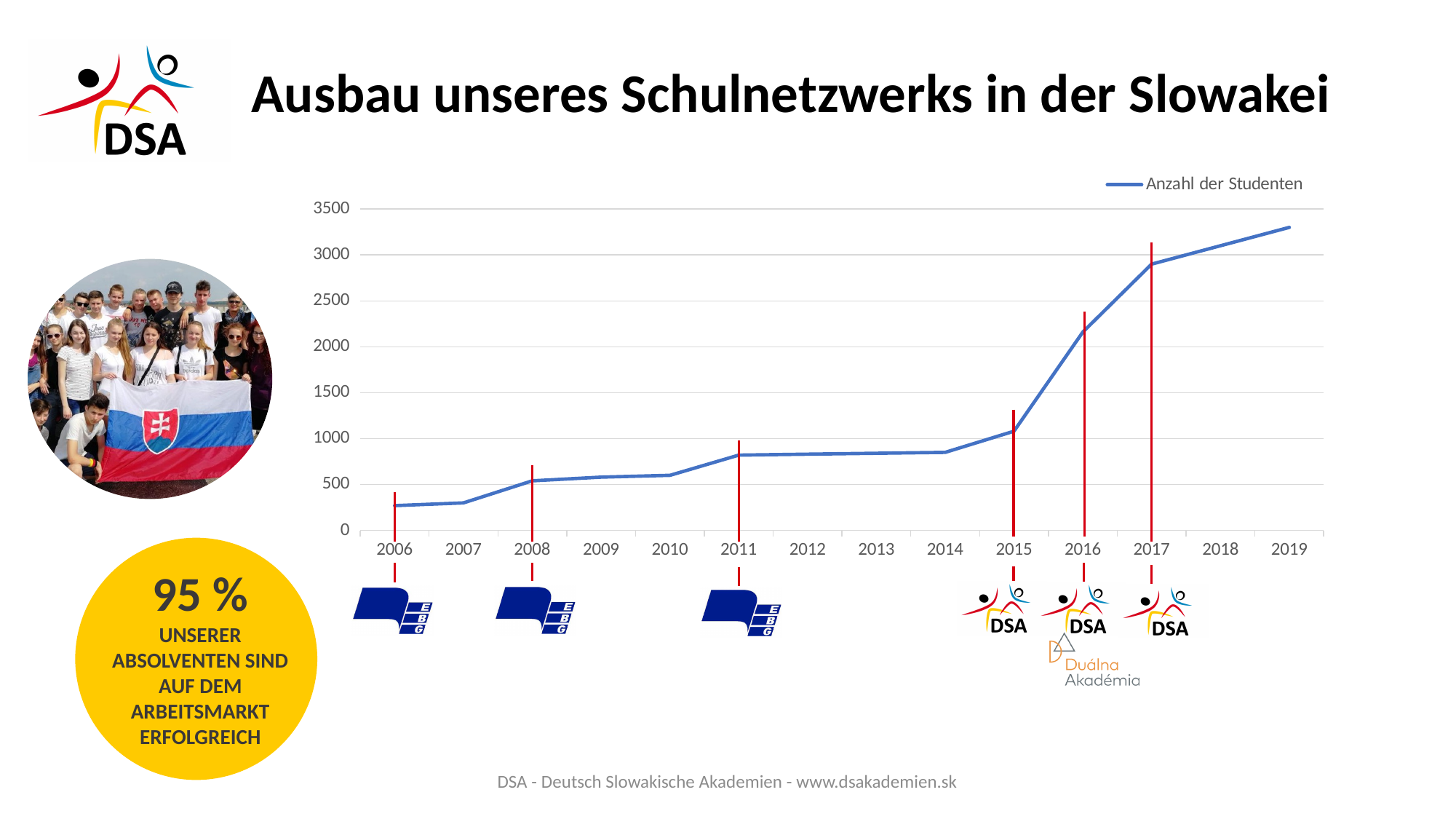
Is the value for Anzahl der Studenten in 2016 greater or less than 2000? greater What is the name of the series shown in the chart legend? Anzahl der Studenten What kind of chart is shown on the slide? line chart What is the highest value shown on the chart's y axis? 3500 Is the value for Anzahl der Studenten in 2006 greater or less than 500? less How many years are plotted along the x axis of the chart? 14 Is the value for Anzahl der Studenten in 2014 greater or less than 1000? less How many series does the chart legend list? 1 Do the values for Anzahl der Studenten generally rise or fall from 2006 to 2019? rise Which year has the larger value for Anzahl der Studenten, 2011 or 2016? 2016 Which year has the highest value for Anzahl der Studenten? 2019